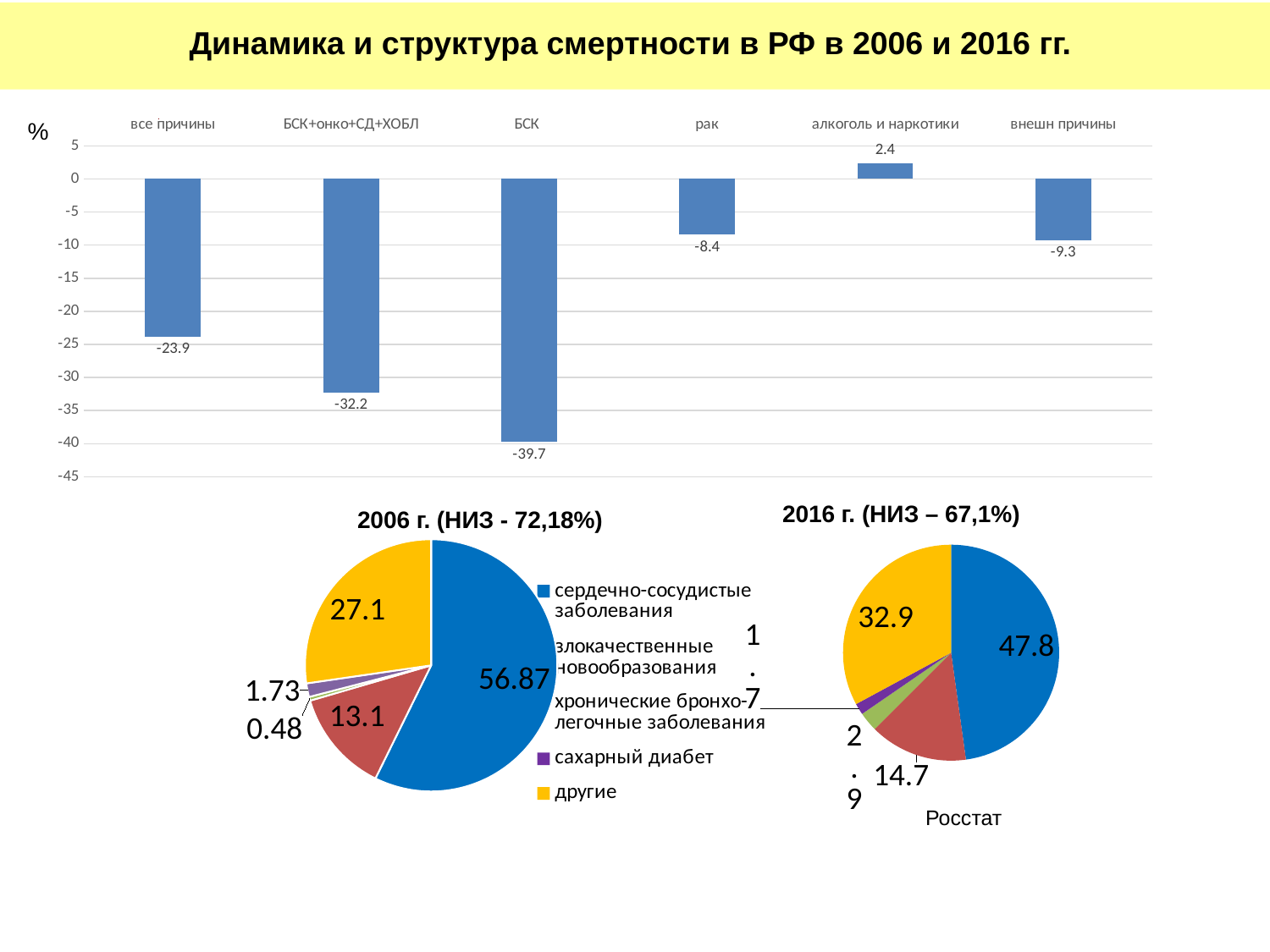
How many entries does the legend of the pie charts list? 5 In the top bar chart, which is larger, the value for рак or the value for внешн причины? рак In the pie chart titled '2016 г. (НИЗ – 67,1%)', what is the value for другие? 32.9 In the top bar chart, what is the value for алкоголь и наркотики? 2.4 In the top bar chart, what is the value for все причины? -23.9 In the top bar chart, which category has the highest value? алкоголь и наркотики How many categories are shown in the top bar chart? 6 In the top bar chart, what is the difference between the values for БСК+онко+СД+ХОБЛ and рак? 23.8 What type of chart is the top chart on the slide? bar chart In the top bar chart, which category has the lowest value? БСК In the top bar chart, what is the value for БСК? -39.7 In the pie chart titled '2006 г. (НИЗ - 72,18%)', what is the value for сердечно-сосудистые заболевания? 56.87